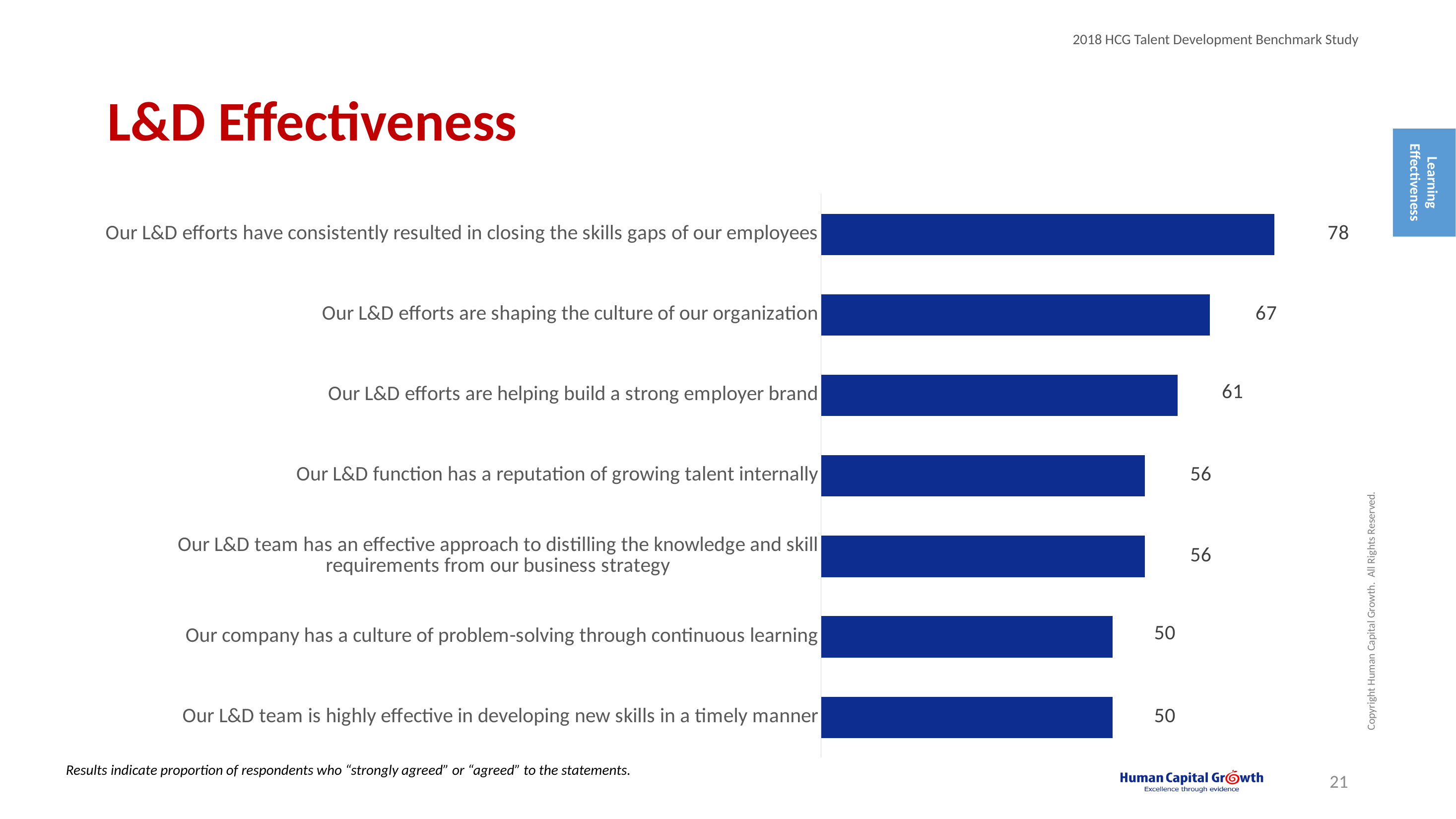
What is the value for "Our company has a culture of problem-solving through continuous learning"? 50 What is the difference between the values for "Our L&D efforts have consistently resulted in closing the skills gaps of our employees" and "Our L&D efforts are shaping the culture of our organization"? 11 Which statement has the highest value? Our L&D efforts have consistently resulted in closing the skills gaps of our employees How many statements are shown in the chart? 7 What is the value for "Our L&D efforts are shaping the culture of our organization"? 67 What is the difference between the values for "Our L&D efforts are helping build a strong employer brand" and "Our L&D function has a reputation of growing talent internally"? 5 What is the title of the slide? L&D Effectiveness What is the value for "Our L&D efforts are helping build a strong employer brand"? 61 What is the value for "Our L&D efforts have consistently resulted in closing the skills gaps of our employees"? 78 How many statements have a value of 50? 2 What kind of chart is shown on the slide? Bar chart Which is larger: the value for "Our L&D efforts are shaping the culture of our organization" or the value for "Our L&D team is highly effective in developing new skills in a timely manner"? Our L&D efforts are shaping the culture of our organization